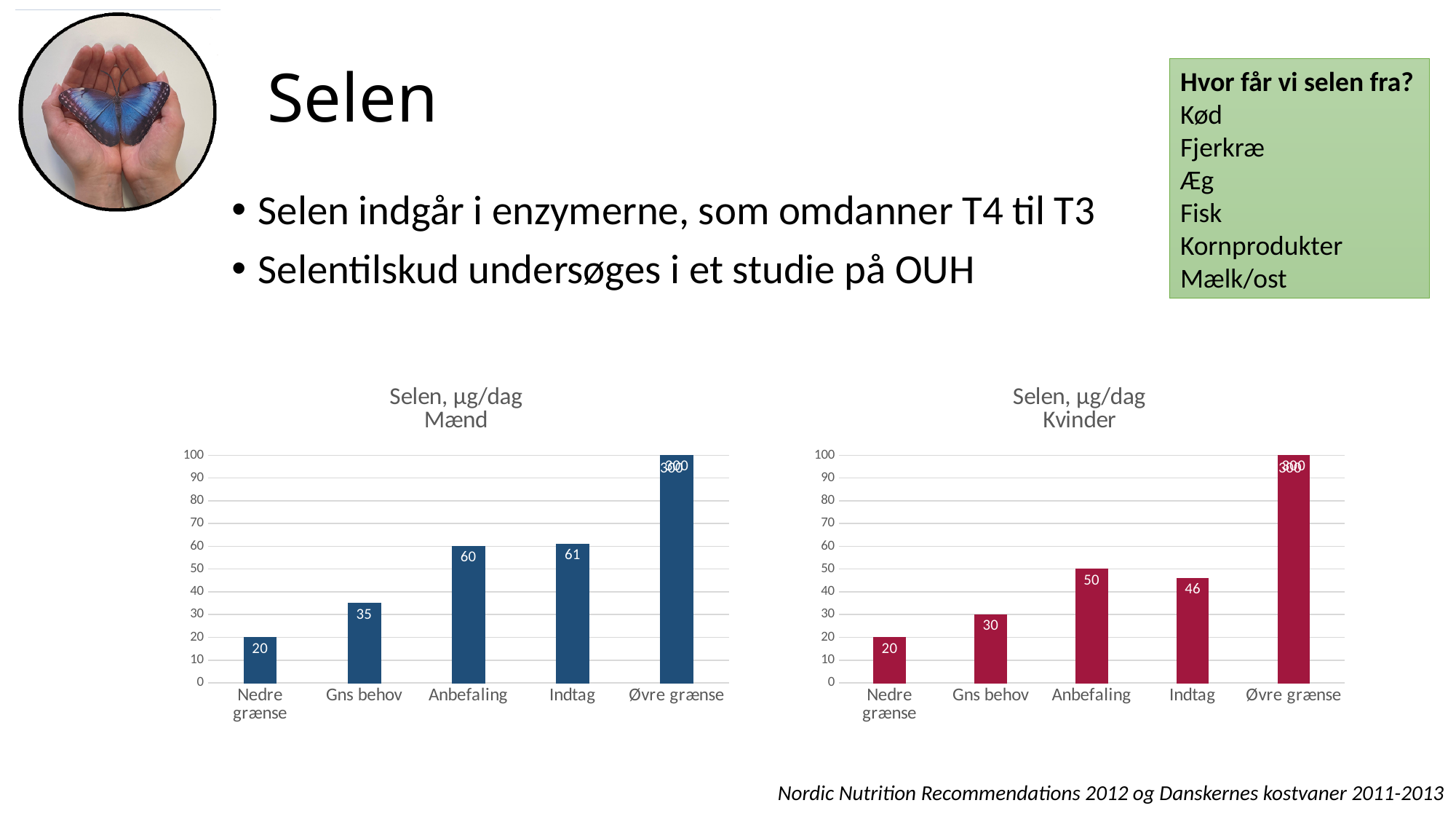
What type of chart is the 'Selen, µg/dag Mænd' chart? Bar chart In the 'Selen, µg/dag Mænd' chart, what is the difference between Anbefaling and Gns behov? 25 In the 'Selen, µg/dag Kvinder' chart, which category has the highest bar? Øvre grænse In the 'Selen, µg/dag Mænd' chart, is the value for Anbefaling greater or less than 50? greater In the 'Selen, µg/dag Mænd' chart, which category has the lowest value? Nedre grænse In the 'Selen, µg/dag Mænd' chart, what is the value for Indtag? 61 How many categories are shown in the 'Selen, µg/dag Kvinder' chart? 5 In the 'Selen, µg/dag Kvinder' chart, what is the difference between Anbefaling and Indtag? 4 In the 'Selen, µg/dag Kvinder' chart, which is larger, Anbefaling or Indtag? Anbefaling In the 'Selen, µg/dag Mænd' chart, what is the value for Gns behov? 35 In the 'Selen, µg/dag Kvinder' chart, what is the value for Anbefaling? 50 In the 'Selen, µg/dag Kvinder' chart, what is the value for Indtag? 46